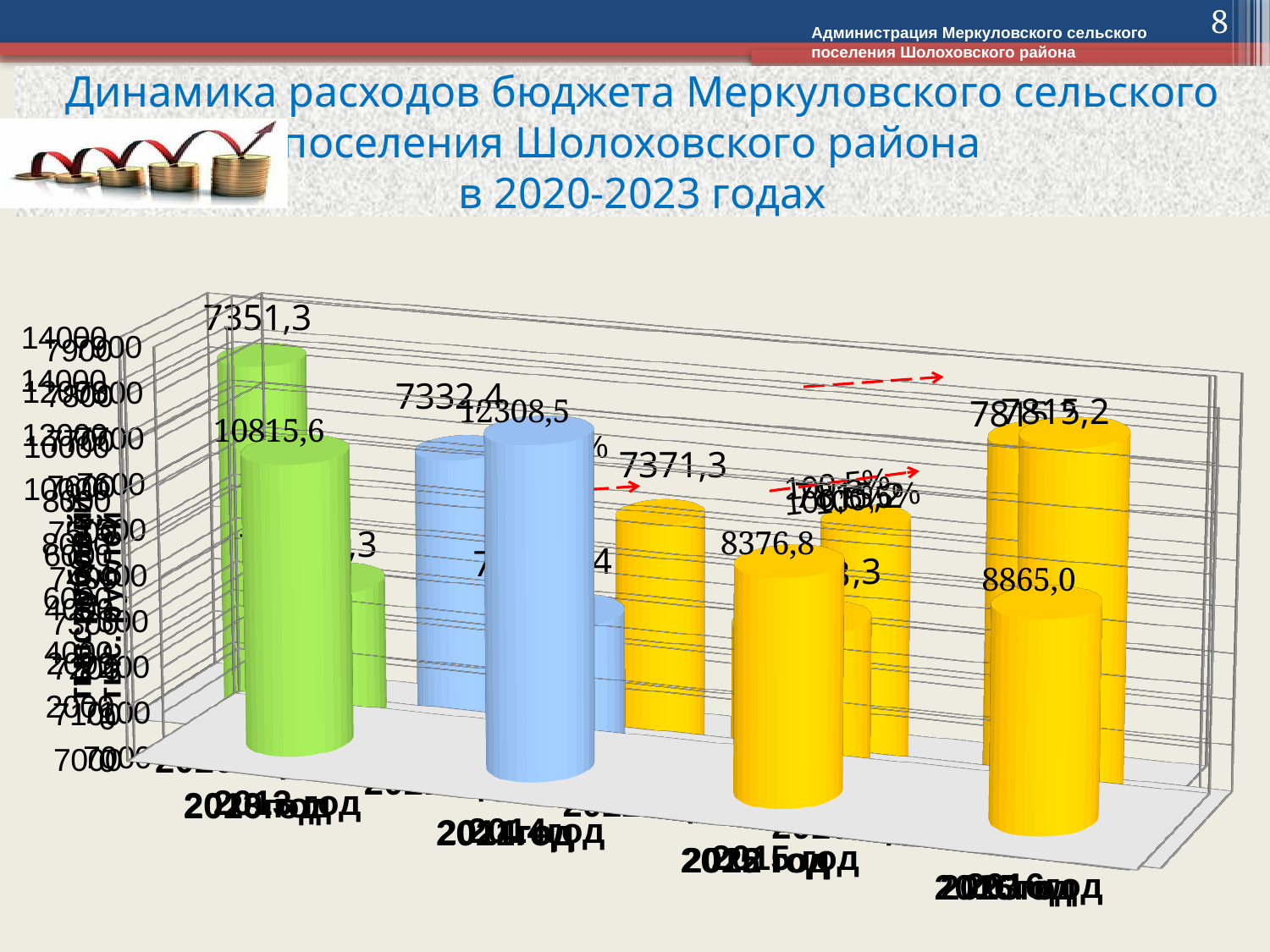
What kind of chart is shown on the slide? bar chart What value is printed on the tallest blue cylinder in the chart? 12308,5 What three colours are used for the cylinders in the chart? green, blue and yellow What is the title of the chart on the slide? Динамика расходов бюджета Меркуловского сельского поселения Шолоховского района в 2020-2023 годах